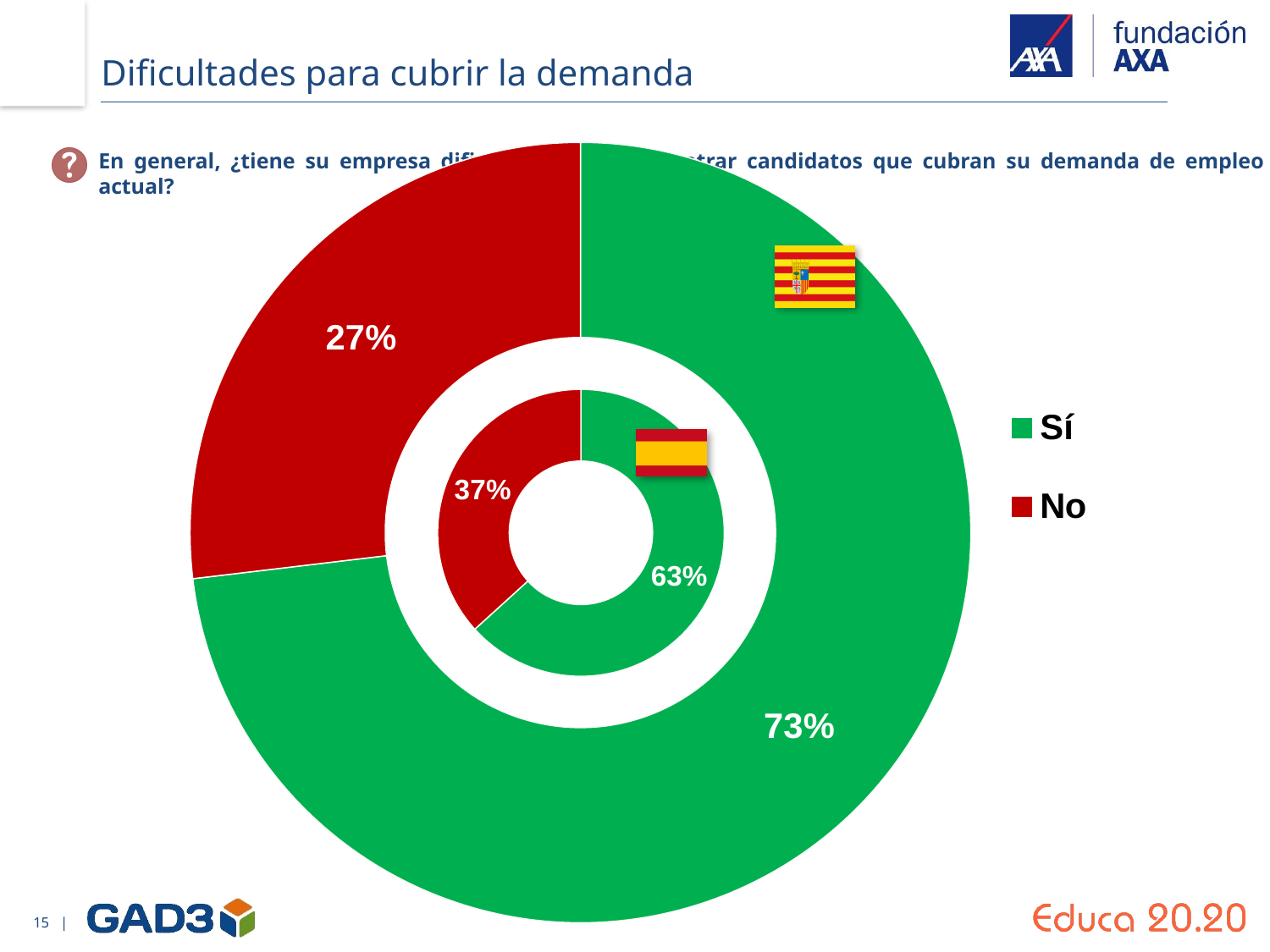
What kind of chart is shown on the slide? Doughnut chart Which colour represents the No category in the chart? Red In the outer ring, which category has the largest share? Sí What is the difference between Sí and No in the outer ring? 46% In the inner ring of the doughnut chart, what is the value for No? 37% In the outer ring of the doughnut chart, what is the value for No? 27% Which is larger: the Sí value in the outer ring or the Sí value in the inner ring? Outer ring (73%) In the inner ring of the doughnut chart, what is the value for Sí? 63% In the inner ring, which category has the smallest share? No How many series does the legend list? 2 In the outer ring of the doughnut chart, what is the value for Sí? 73% What are the two entries in the legend? Sí and No